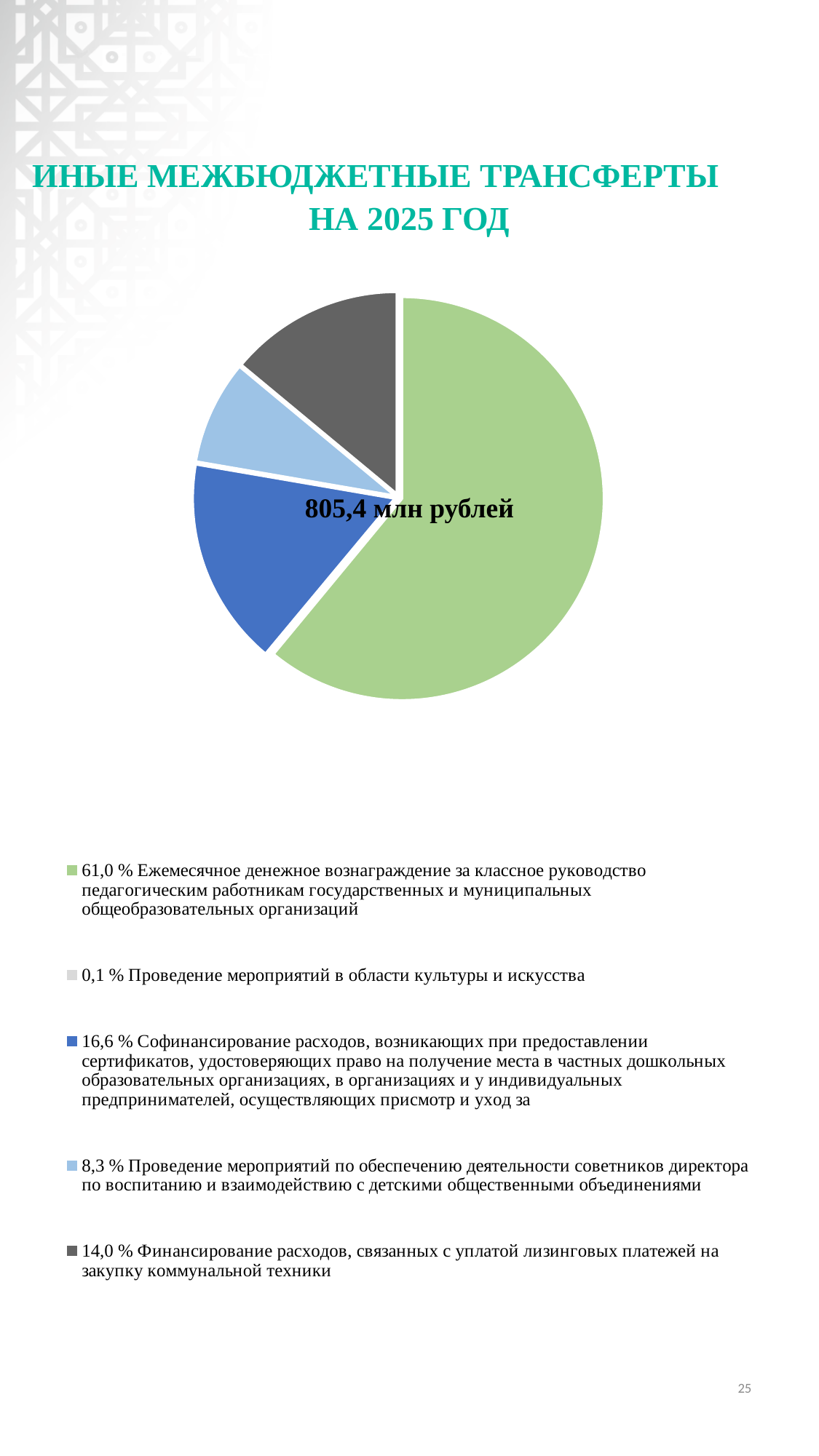
What share of the pie is 'Ежемесячное денежное вознаграждение за классное руководство педагогическим работникам государственных и муниципальных общеобразовательных организаций'? 61,0 % What kind of chart is shown on the slide? pie chart What share of the pie is 'Софинансирование расходов, возникающих при предоставлении сертификатов, удостоверяющих право на получение места в частных дошкольных образовательных организациях...'? 16,6 % What total amount is printed in the centre of the pie chart? 805,4 млн рублей What share of the pie is 'Проведение мероприятий по обеспечению деятельности советников директора по воспитанию и взаимодействию с детскими общественными объединениями'? 8,3 % Which category has the smallest share of the pie? Проведение мероприятий в области культуры и искусства Which share is larger: 'Софинансирование расходов...' (сертификаты) or 'Финансирование расходов, связанных с уплатой лизинговых платежей на закупку коммунальной техники'? Софинансирование расходов... (сертификаты) What is the difference in percentage points between the share for 'Ежемесячное денежное вознаграждение за классное руководство...' and the share for 'Софинансирование расходов...' (сертификаты)? 44,4 Which category has the largest share of the pie? Ежемесячное денежное вознаграждение за классное руководство педагогическим работникам государственных и муниципальных общеобразовательных организаций How many categories does the legend of the pie chart list? 5